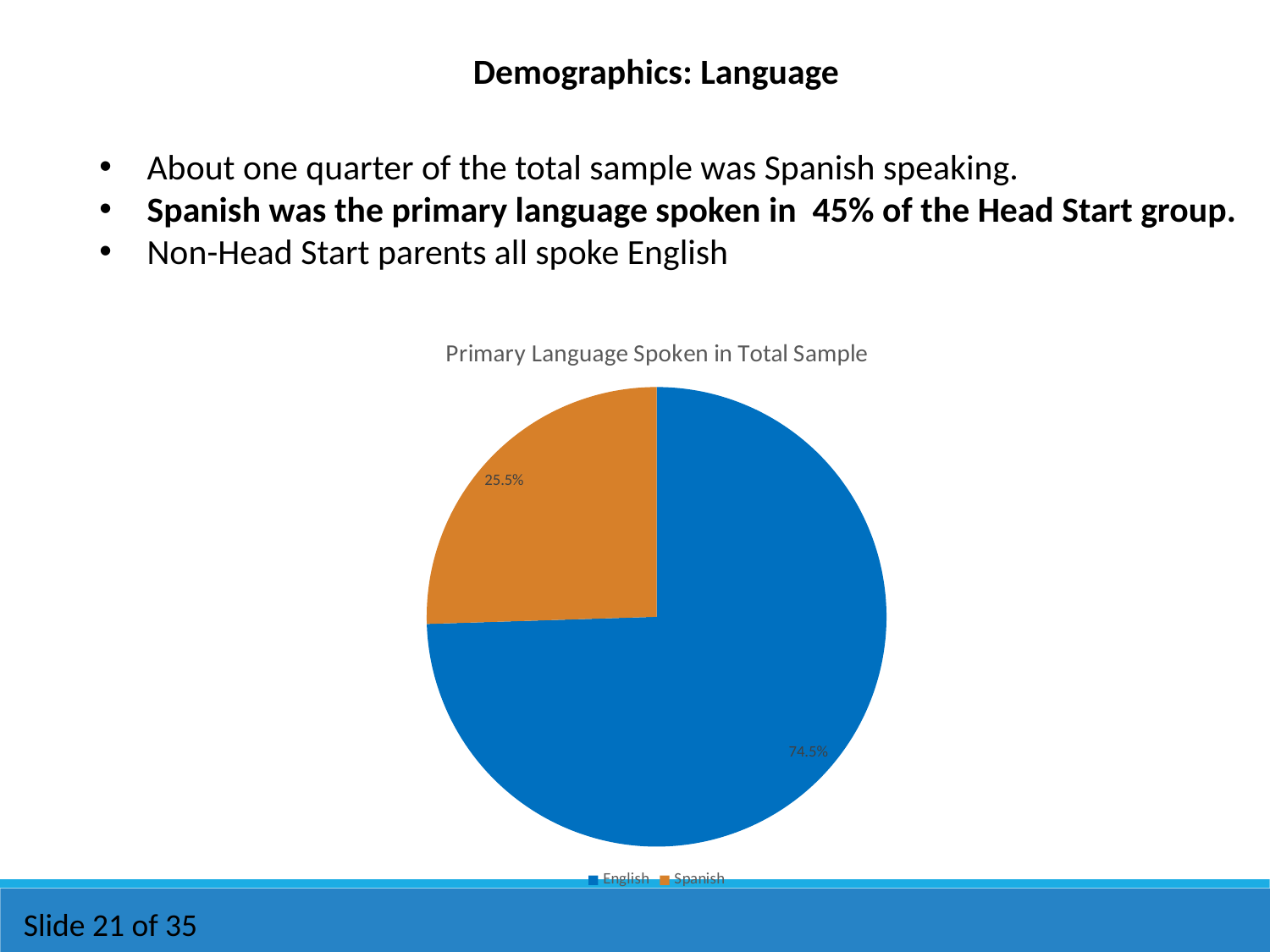
Which slice is larger, English or Spanish? English What share of the pie does the Spanish slice represent? 25.5% How many slices does the pie chart have? 2 What is the difference in percentage points between the English and Spanish slices? 49 Which language has the smallest share of the pie? Spanish How many entries does the legend list? 2 What is the title of the chart? Primary Language Spoken in Total Sample What colour is the Spanish slice? orange What percentage of the total sample spoke Spanish as the primary language? 25.5% What type of chart is shown on the slide? pie chart What percentage of the total sample spoke English as the primary language? 74.5% Which language has the largest share of the pie? English